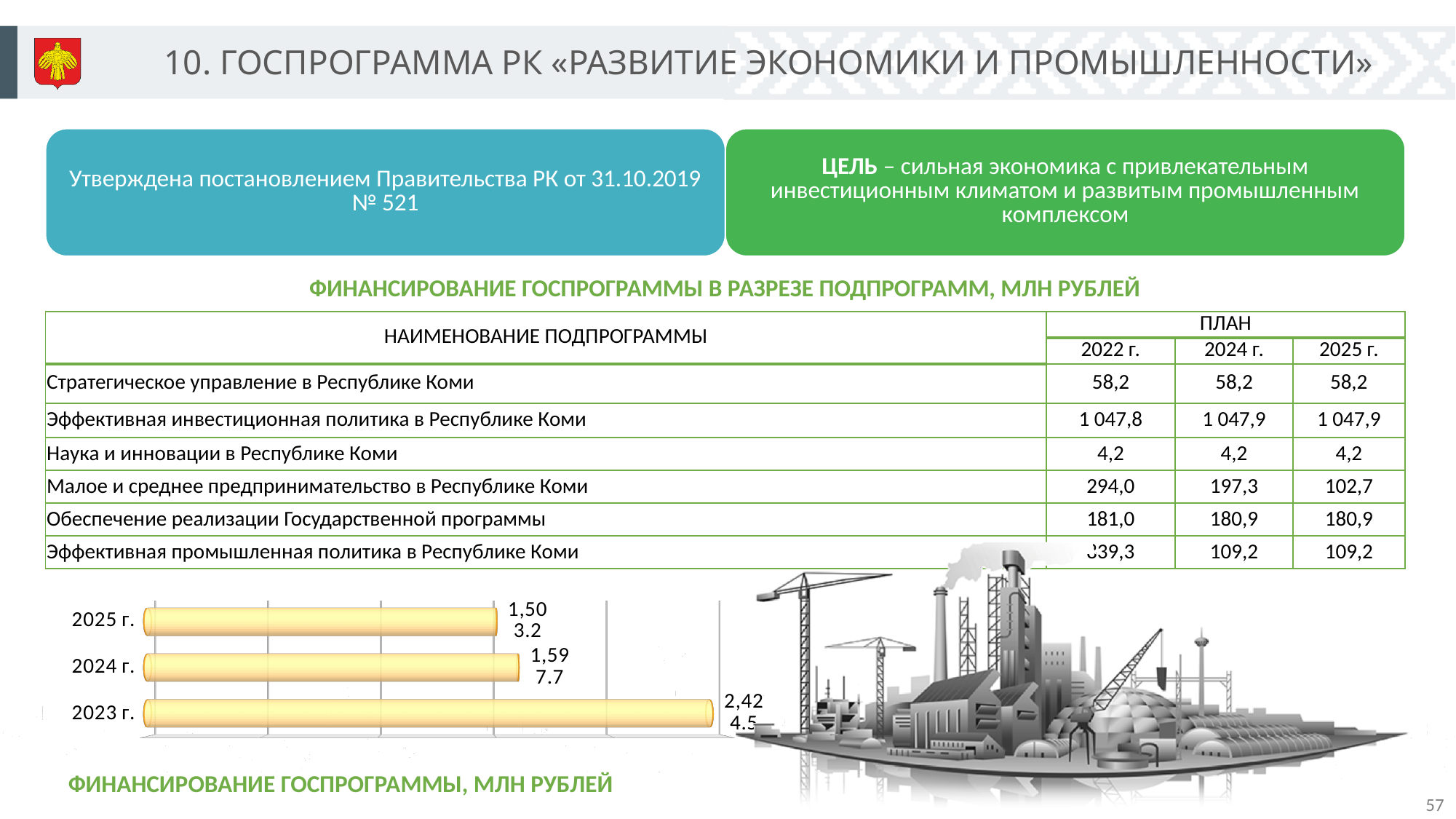
In the bar chart, which is larger: the value for 2023 г. or the value for 2024 г.? 2023 г. What is the value shown for 2024 г. in the bar chart? 1,597.7 How many categories (years) does the bar chart show? 3 Which year has the lowest value in the bar chart? 2025 г. Which year has the highest value in the bar chart? 2023 г. What type of chart is shown at the bottom left of the slide? bar chart What is the title of the bar chart? ФИНАНСИРОВАНИЕ ГОСПРОГРАММЫ, МЛН РУБЛЕЙ Do the values in the bar chart rise or fall from 2023 г. to 2025 г.? fall What is the value shown for 2023 г. in the bar chart? 2,424.5 What colour are the bars in the bar chart? yellow In the bar chart, is the value for 2024 г. larger or smaller than the value for 2025 г.? larger What is the value shown for 2025 г. in the bar chart? 1,503.2